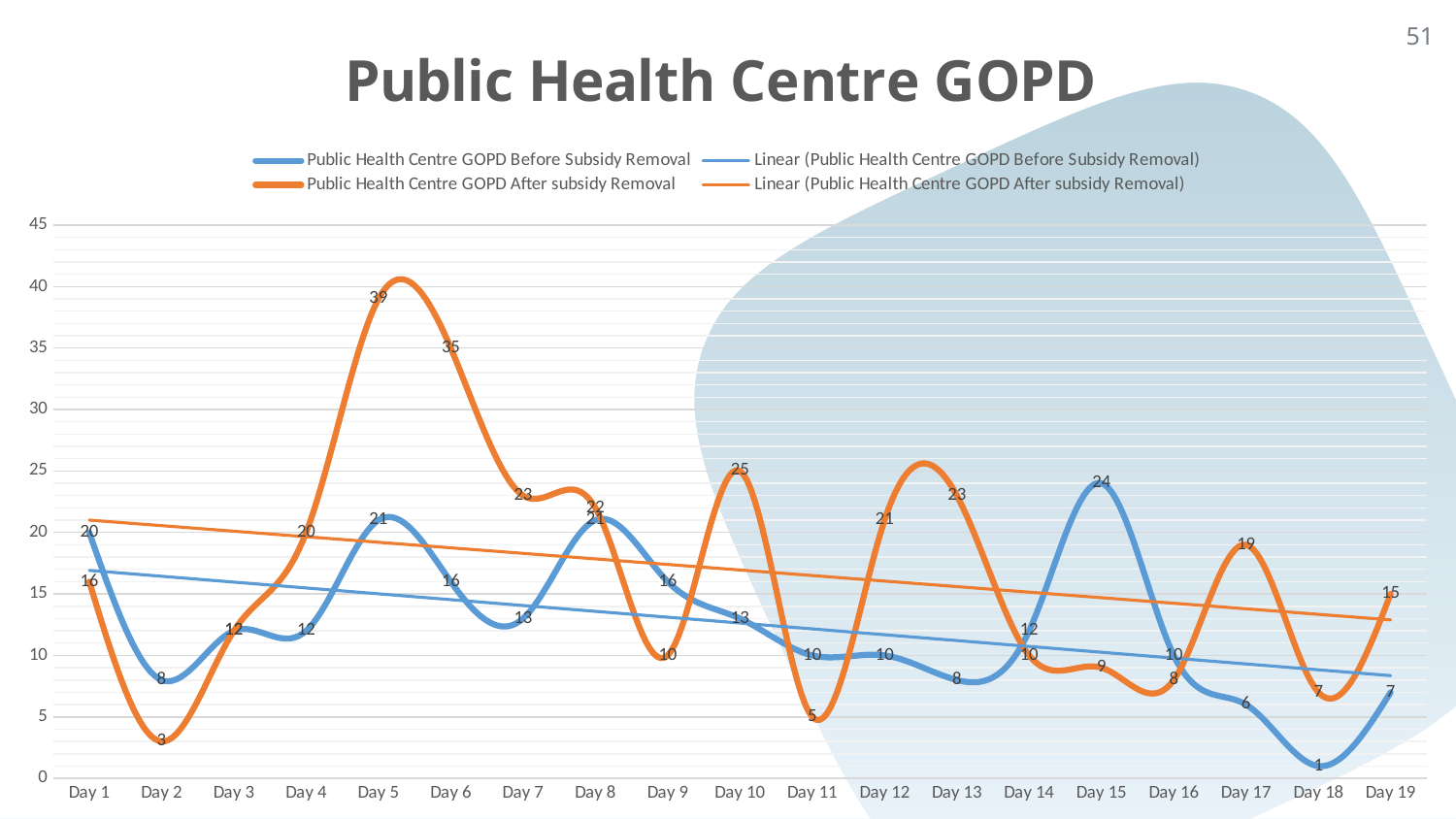
What is the value for Public Health Centre GOPD Before Subsidy Removal on Day 15? 24 Is the value for Public Health Centre GOPD After subsidy Removal on Day 6 greater or less than 30? greater How many entries does the legend list? 4 Does the linear trendline for Public Health Centre GOPD Before Subsidy Removal rise or fall from Day 1 to Day 19? fall What kind of chart is shown on the slide? line chart How many days are plotted along the x axis? 19 On Day 5, what is the difference between the After subsidy Removal value and the Before Subsidy Removal value? 18 On Day 10, which series has the larger value, Before Subsidy Removal or After subsidy Removal? After subsidy Removal On which day does the Public Health Centre GOPD Before Subsidy Removal series reach its lowest value? Day 18 What is the value for Public Health Centre GOPD After subsidy Removal on Day 5? 39 What is the value for Public Health Centre GOPD After subsidy Removal on Day 11? 5 On which day does the Public Health Centre GOPD After subsidy Removal series reach its highest value? Day 5